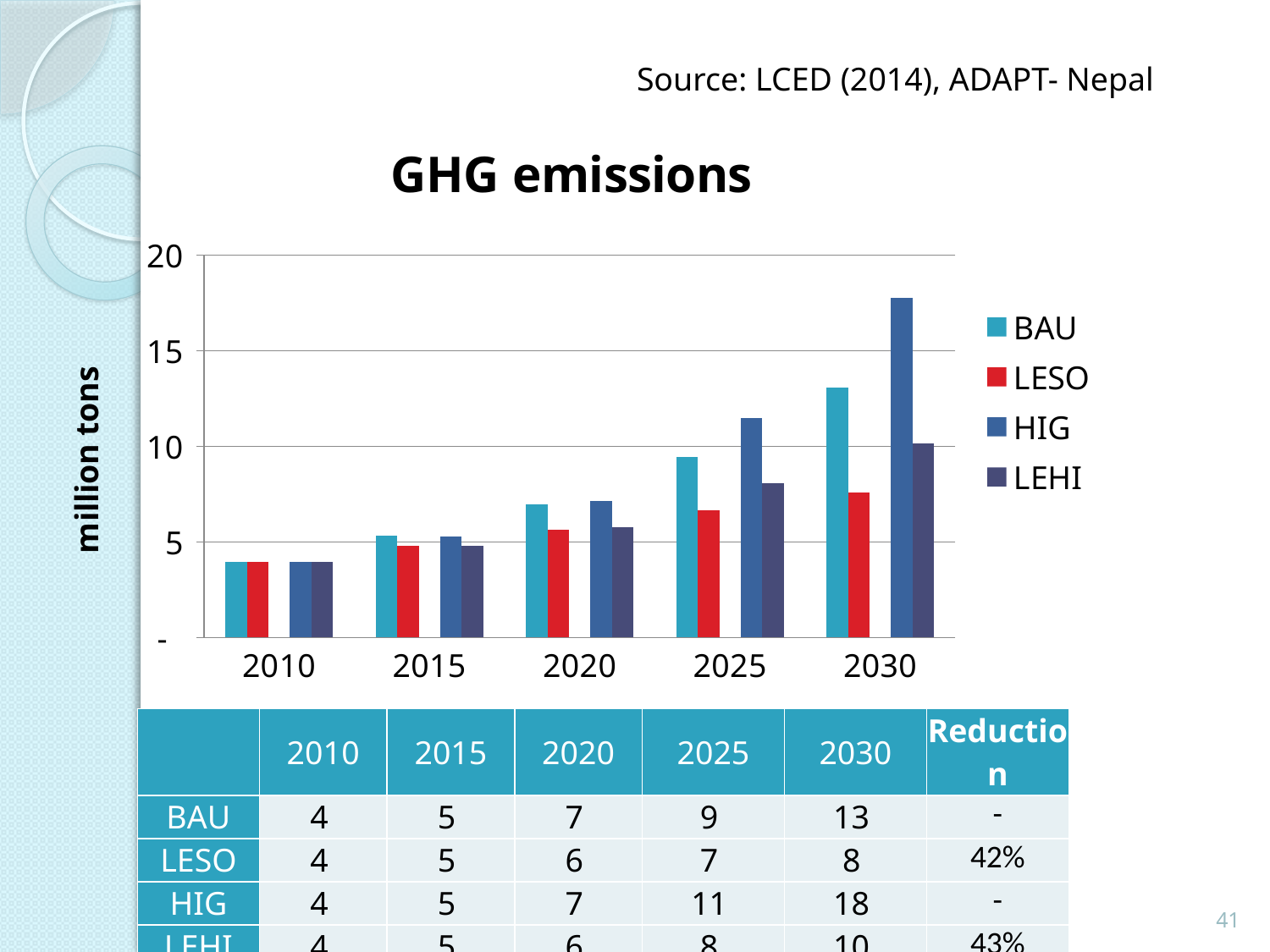
What kind of chart is the GHG emissions chart? bar chart How many years are shown on the x axis of the GHG emissions chart? 5 Which series has the lowest GHG emissions in 2030? LESO Is the HIG value for 2030 greater or less than 15? greater Do the BAU emissions rise or fall from 2010 to 2030? rise Is the BAU value for 2025 greater or less than 10? less What is the label on the y axis of the GHG emissions chart? million tons Using the table values, what is the difference between BAU and LESO in 2030? 5 According to the table, what is the BAU value for 2030? 13 How many series does the legend of the GHG emissions chart list? 4 According to the table, what is the HIG value for 2025? 11 Which series has the highest GHG emissions in 2030? HIG